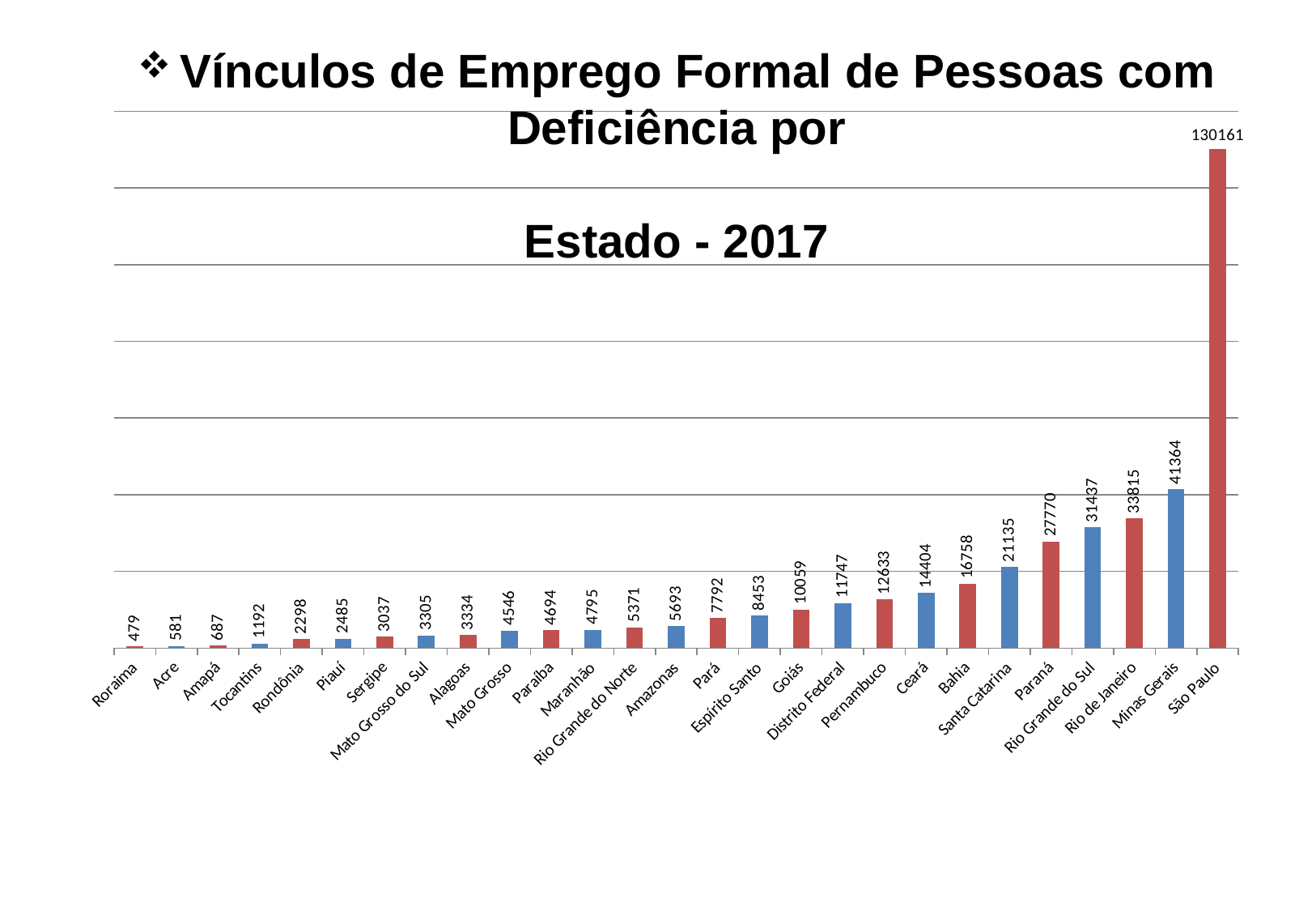
What is the value for São Paulo? 130161 Which state has the lowest value? Roraima Which state has the highest value? São Paulo What is the value for Tocantins? 1192 What is the value for Bahia? 16758 What is the difference between the values for São Paulo and Minas Gerais? 88797 What kind of chart is shown on the slide? Bar chart Do the values rise or fall from left to right along the x axis? Rise What is the difference between the values for Rio de Janeiro and Rio Grande do Sul? 2378 Which is larger, the value for Paraná or the value for Santa Catarina? Paraná How many states are shown on the chart? 27 What is the value for Minas Gerais? 41364